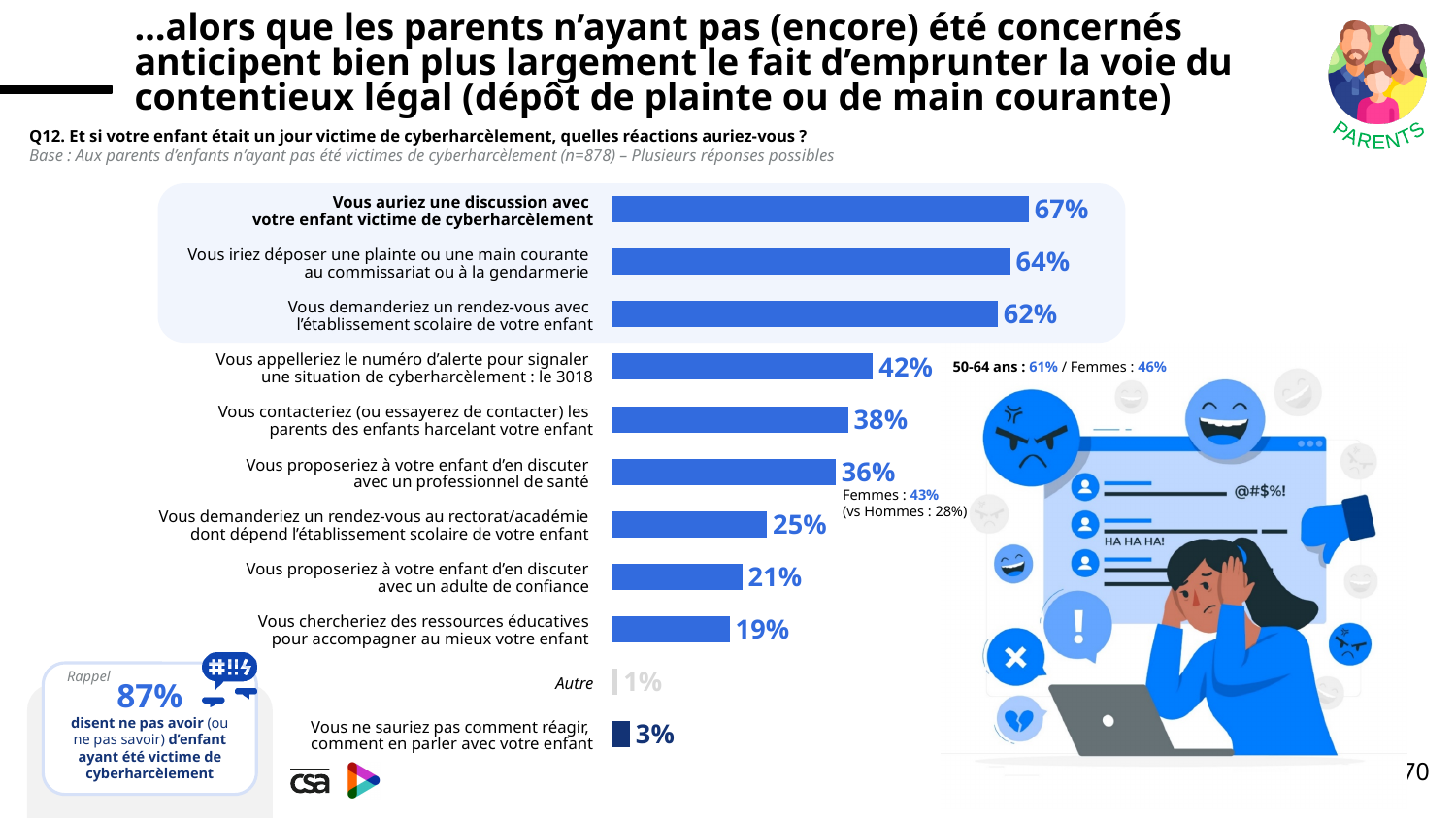
Which response has the highest percentage in the chart? Vous auriez une discussion avec votre enfant victime de cyberharcèlement What type of chart is used on this slide? Bar chart What percentage would call the alert number 3018 ("Vous appelleriez le numéro d'alerte pour signaler une situation de cyberharcèlement : le 3018")? 42% What is the value for "Vous iriez déposer une plainte ou une main courante au commissariat ou à la gendarmerie"? 64% What is the difference between the percentage for "Vous iriez déposer une plainte ou une main courante" and the percentage for "Vous demanderiez un rendez-vous avec l'établissement scolaire de votre enfant"? 2 percentage points Which is larger: the value for "Vous contacteriez (ou essayerez de contacter) les parents des enfants harcelant votre enfant" or the value for "Vous proposeriez à votre enfant d'en discuter avec un professionnel de santé"? Vous contacteriez (ou essayerez de contacter) les parents des enfants harcelant votre enfant How many response categories are plotted in the bar chart? 11 What is the difference between the value for "Vous proposeriez à votre enfant d'en discuter avec un adulte de confiance" and the value for "Vous chercheriez des ressources éducatives pour accompagner au mieux votre enfant"? 2 percentage points What percentage of parents say they would have a discussion with their child who is a victim of cyberbullying ("Vous auriez une discussion avec votre enfant victime de cyberharcèlement")? 67% What is the value for "Vous ne sauriez pas comment réagir, comment en parler avec votre enfant"? 3% Which response has the lowest percentage in the chart? Autre What is the base (n) of parents surveyed for this question, as stated under the question text? n=878